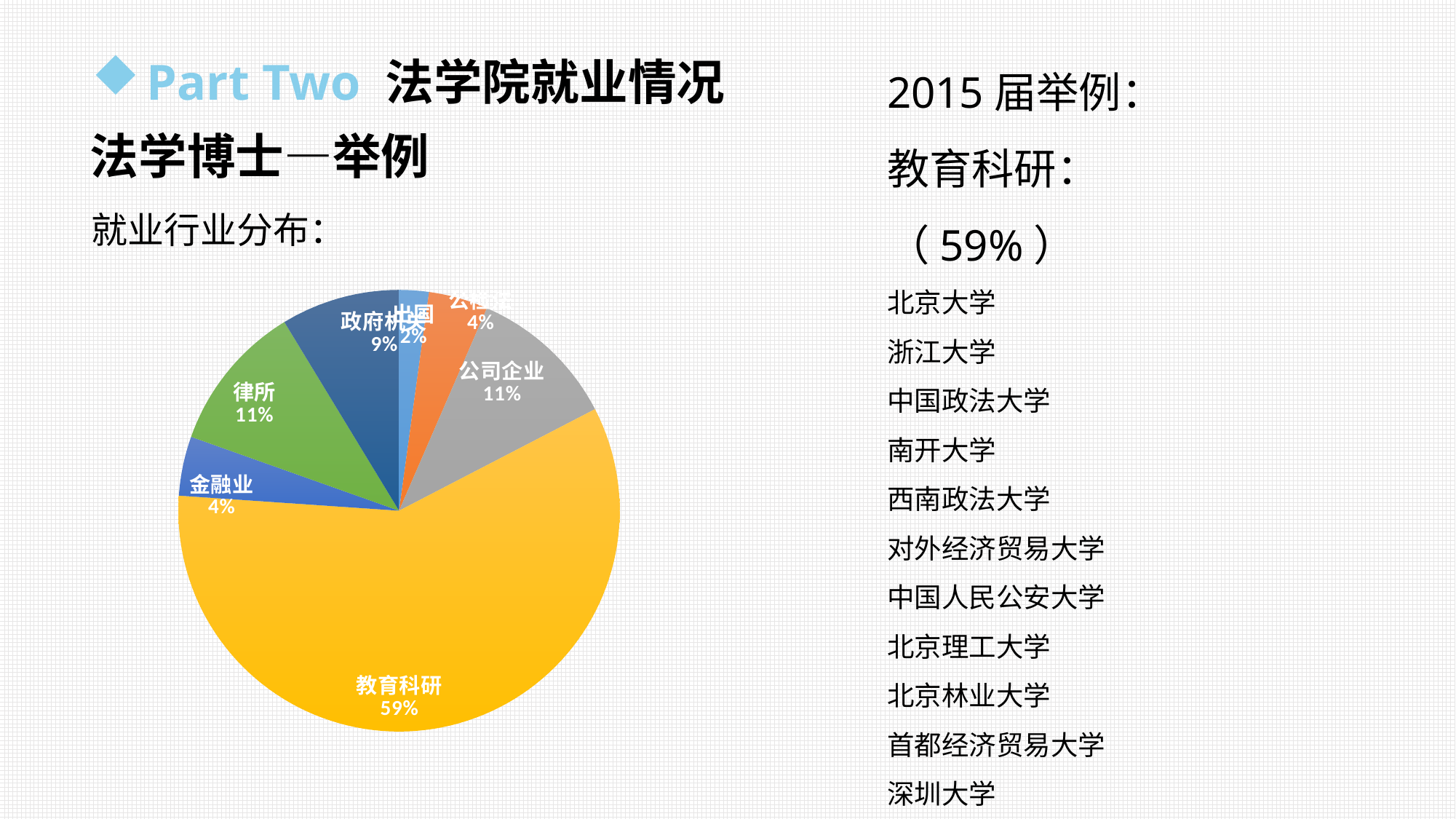
What is the difference in percentage points between the 律所 slice and the 金融业 slice? 7% How many slices does the pie chart have? 7 Which slice is larger, 政府机关 or 金融业? 政府机关 What percentage does the 教育科研 slice represent in the pie chart? 59% What is the difference in percentage points between the 教育科研 slice and the 公司企业 slice? 48% What percentage does the 律所 slice represent in the pie chart? 11% What percentage does the 金融业 slice represent in the pie chart? 4% What percentage does the 公司企业 slice represent in the pie chart? 11% Which category has the largest share in the pie chart? 教育科研 What colour is the 教育科研 slice in the pie chart? yellow What type of chart is shown on the slide? pie chart What percentage does the 政府机关 slice represent in the pie chart? 9%